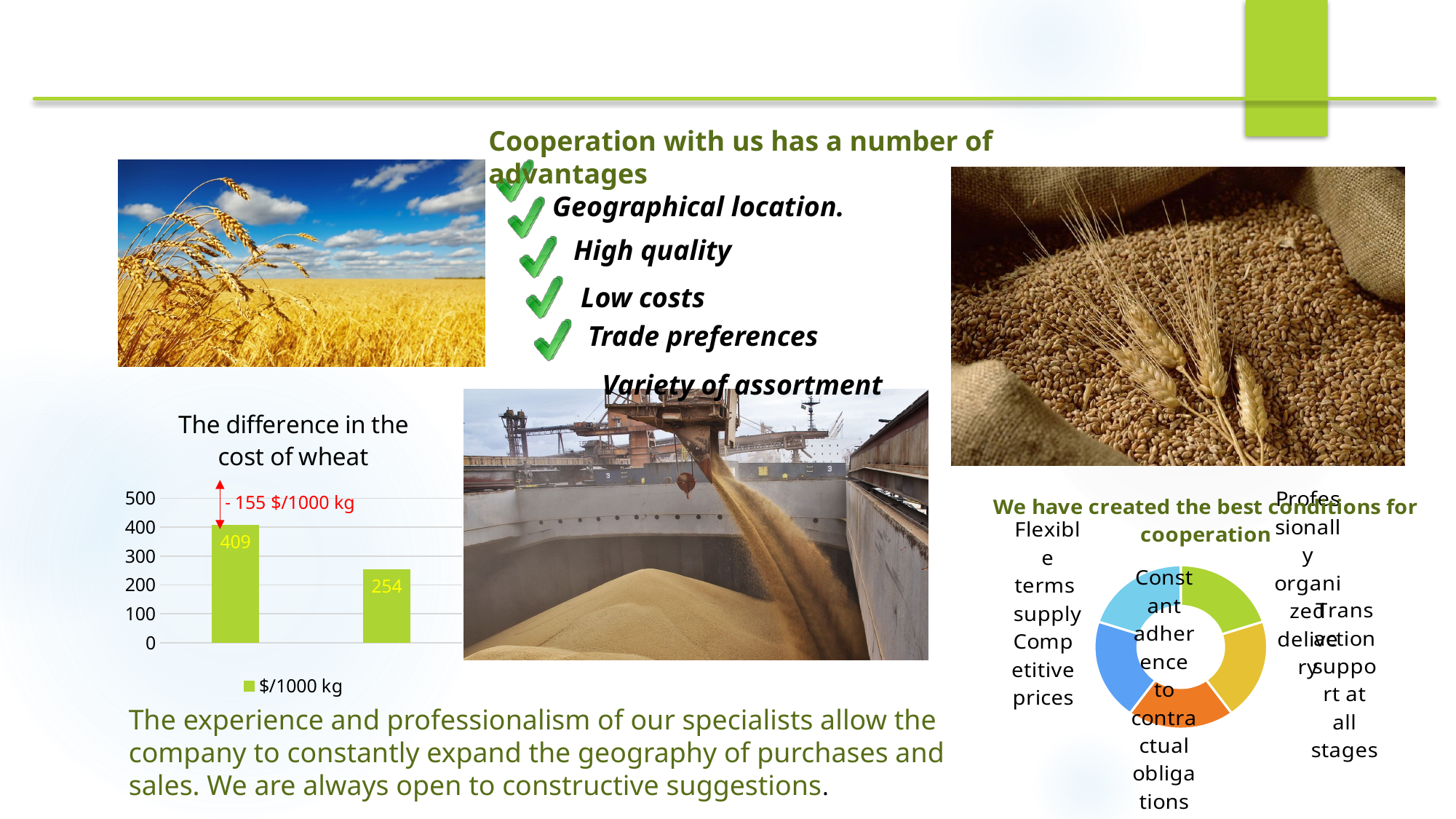
On the chart titled 'The difference in the cost of wheat', what is the legend entry? $/1000 kg On the chart titled 'The difference in the cost of wheat', what is the difference between the left bar and the right bar? 155 On the chart titled 'The difference in the cost of wheat', which bar is taller, the left or the right? left On the chart titled 'The difference in the cost of wheat', what is the value of the left bar? 409 What kind of chart is shown under the heading 'We have created the best conditions for cooperation' on the right of the slide? doughnut chart On the chart titled 'The difference in the cost of wheat', is the value of the right bar greater or less than 300? less How many slices does the doughnut chart on the right of the slide have? 5 What kind of chart is 'The difference in the cost of wheat'? bar chart On the chart titled 'The difference in the cost of wheat', how many bars are plotted? 2 On the chart titled 'The difference in the cost of wheat', what does the red annotation next to the arrow say? - 155 $/1000 kg On the chart titled 'The difference in the cost of wheat', how many series does the legend list? 1 On the chart titled 'The difference in the cost of wheat', what is the value of the right bar? 254